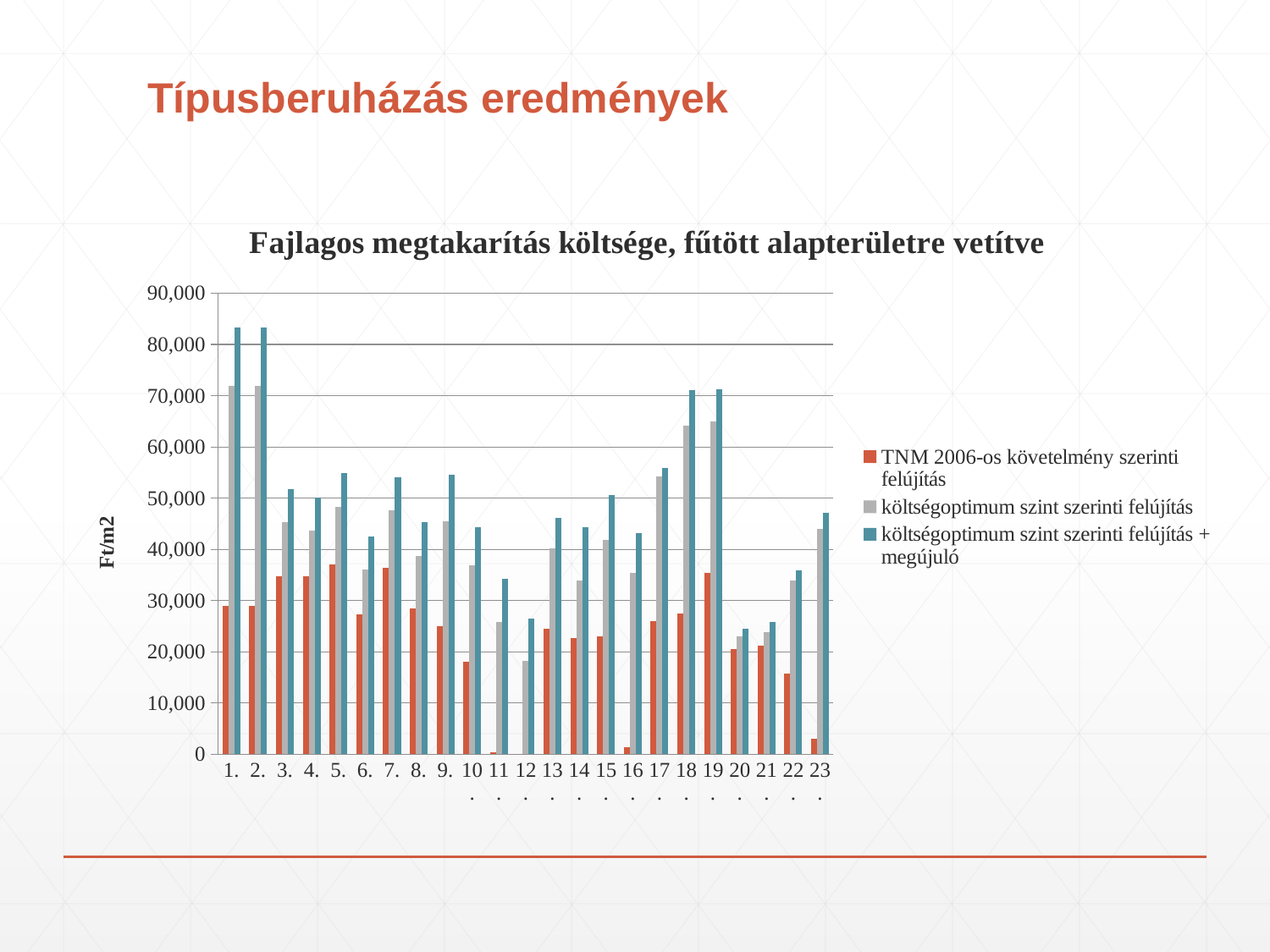
What type of chart is shown on the slide? bar chart What is the title of the chart? Fajlagos megtakarítás költsége, fűtött alapterületre vetítve Is the value for category 11. in the 'TNM 2006-os követelmény szerinti felújítás' series greater or less than 10,000? less Which category has the lowest value in the 'költségoptimum szint szerinti felújítás' series? 12. How many categories are shown along the x axis of the chart? 23 What is the label on the vertical axis of the chart? Ft/m2 Is the value for category 22. in the 'TNM 2006-os követelmény szerinti felújítás' series greater or less than 20,000? less Is the value for category 1. in the 'költségoptimum szint szerinti felújítás + megújuló' series greater or less than 80,000? greater How many series does the chart's legend list? 3 In the 'költségoptimum szint szerinti felújítás + megújuló' series, which is larger: the value for category 1. or the value for category 10.? category 1. For category 9., which series has the larger value: 'TNM 2006-os követelmény szerinti felújítás' or 'költségoptimum szint szerinti felújítás + megújuló'? költségoptimum szint szerinti felújítás + megújuló